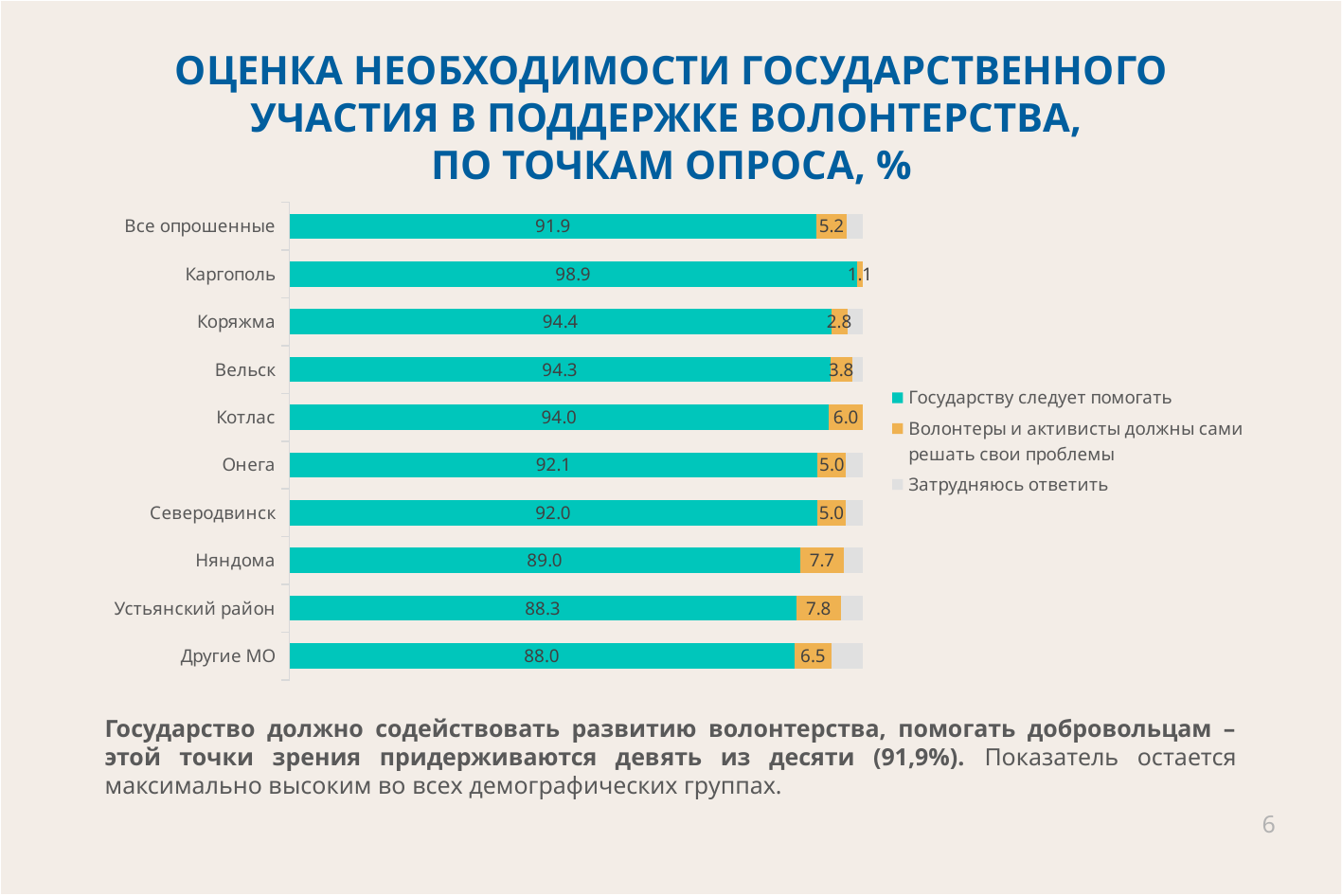
Which category has the lowest value for "Волонтеры и активисты должны сами решать свои проблемы"? Каргополь What kind of chart is shown on the slide? Stacked bar chart What is the value of "Государству следует помогать" for Каргополь? 98.9 What is the difference between the "Волонтеры и активисты должны сами решать свои проблемы" values for Котлас and Онега? 1.0 Which category has the lowest value for "Государству следует помогать"? Другие МО How many categories are shown on the chart? 10 Which has a larger "Государству следует помогать" value, Коряжма or Северодвинск? Коряжма Which category has the highest value for "Государству следует помогать"? Каргополь What is the value of "Волонтеры и активисты должны сами решать свои проблемы" for Няндома? 7.7 What is the value of "Государству следует помогать" for Все опрошенные? 91.9 What is the difference between the "Государству следует помогать" values for Каргополь and Другие МО? 10.9 How many series does the legend list? 3